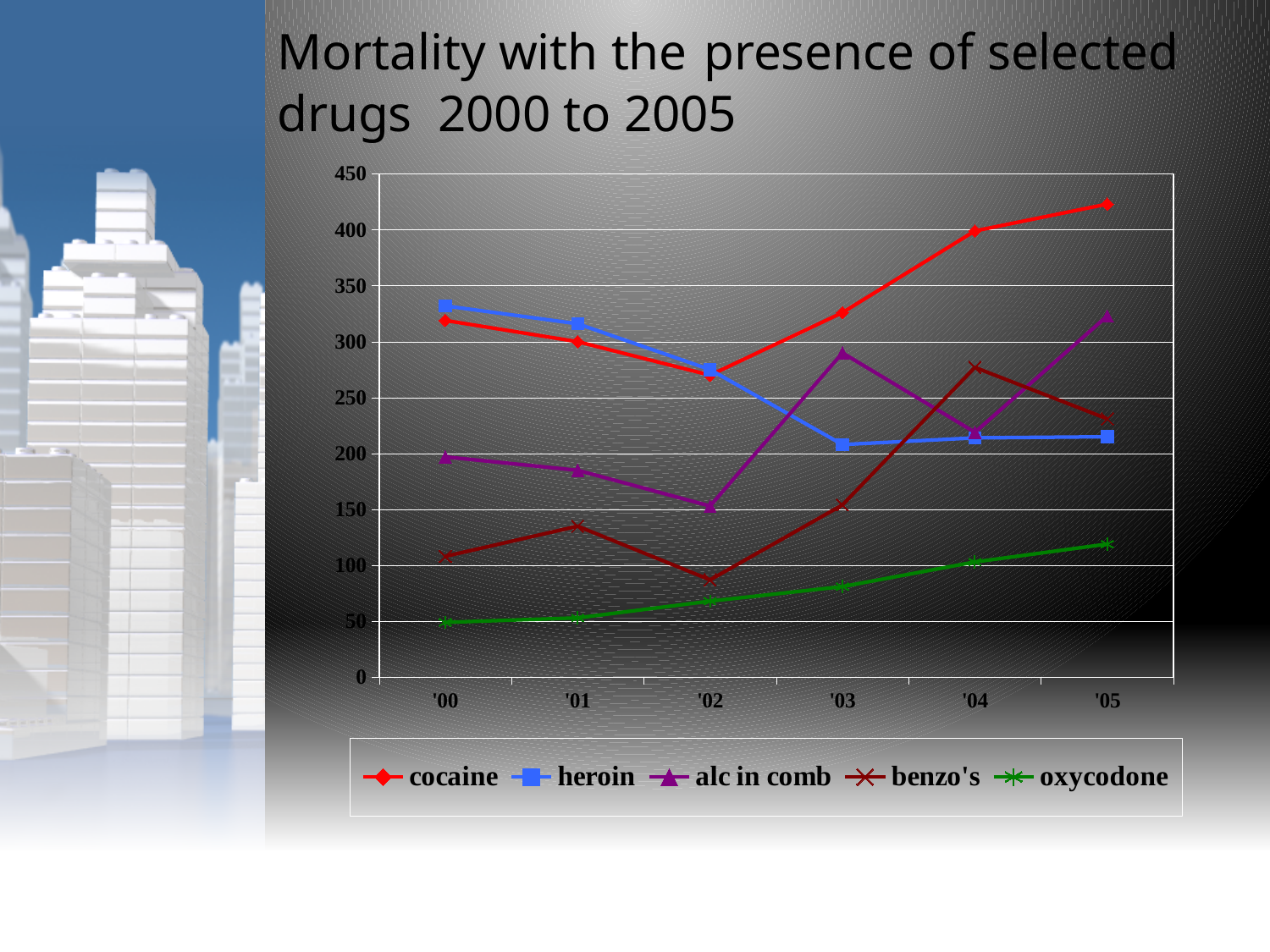
Is the value for cocaine in '05 greater or less than 400? greater Which is larger in '03, alc in comb or heroin? alc in comb Is the value for benzo's in '02 greater or less than 100? less In which year does cocaine reach its highest value? '05 Which series has the highest value in '05? cocaine Is the value for oxycodone in '00 greater or less than 100? less What kind of chart is shown on the slide? line chart How many series does the legend list? 5 Does the oxycodone line rise or fall from '00 to '05? rises Which series has the lowest value in '00? oxycodone How many years are plotted along the x axis? 6